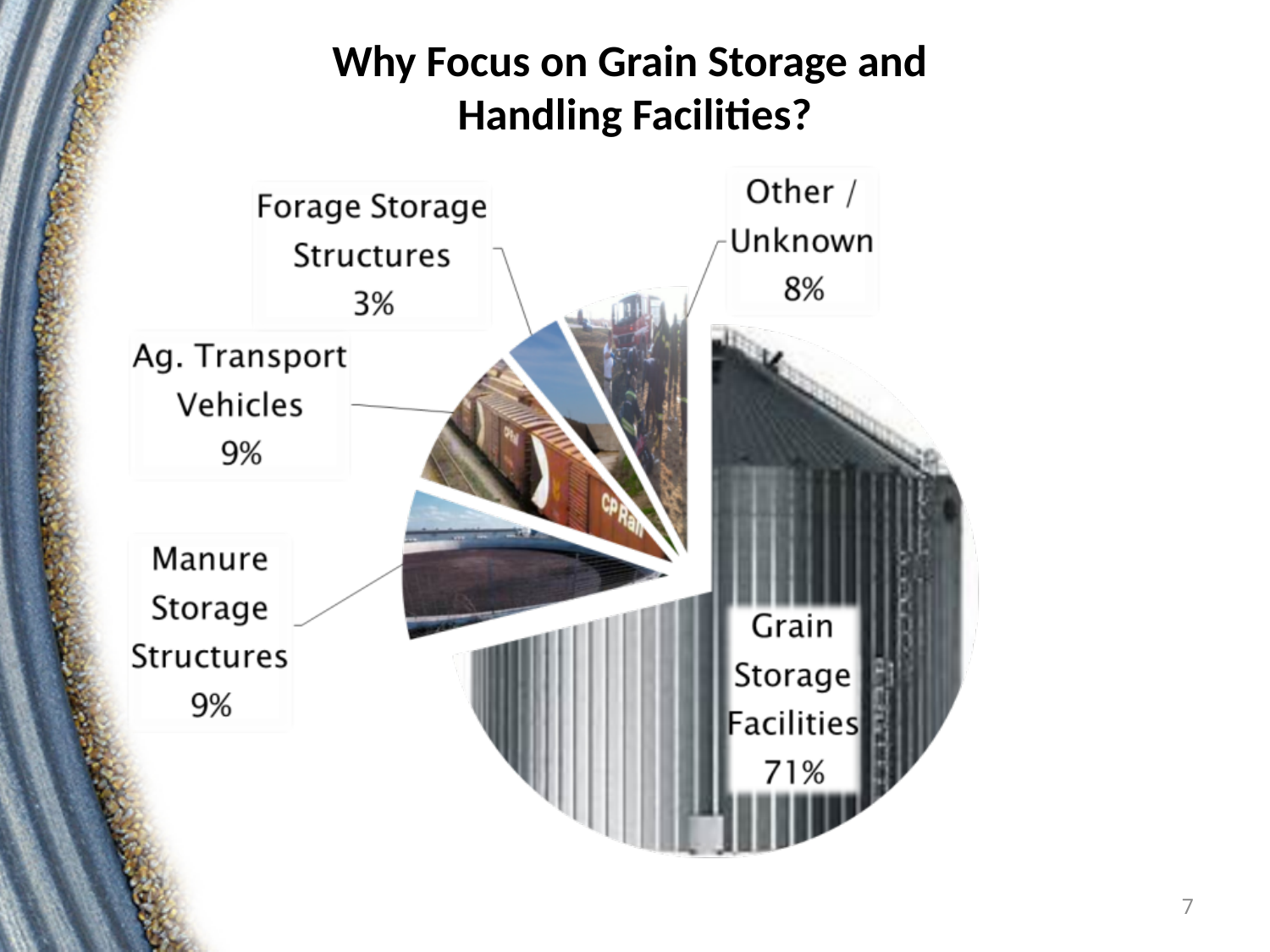
What is the difference in percentage points between Grain Storage Facilities and Other / Unknown? 63 What is the title of the slide containing the pie chart? Why Focus on Grain Storage and Handling Facilities? Which category has the largest slice of the pie? Grain Storage Facilities What share of the pie is Grain Storage Facilities? 71% What percentage is shown for Other / Unknown? 8% What percentage is shown for Forage Storage Structures? 3% How many slices does the pie chart have? 5 Which is larger, Other / Unknown or Forage Storage Structures? Other / Unknown What percentage is shown for Manure Storage Structures? 9% Which category has the smallest slice of the pie? Forage Storage Structures What kind of chart is shown on the slide? pie chart What percentage is shown for Ag. Transport Vehicles? 9%